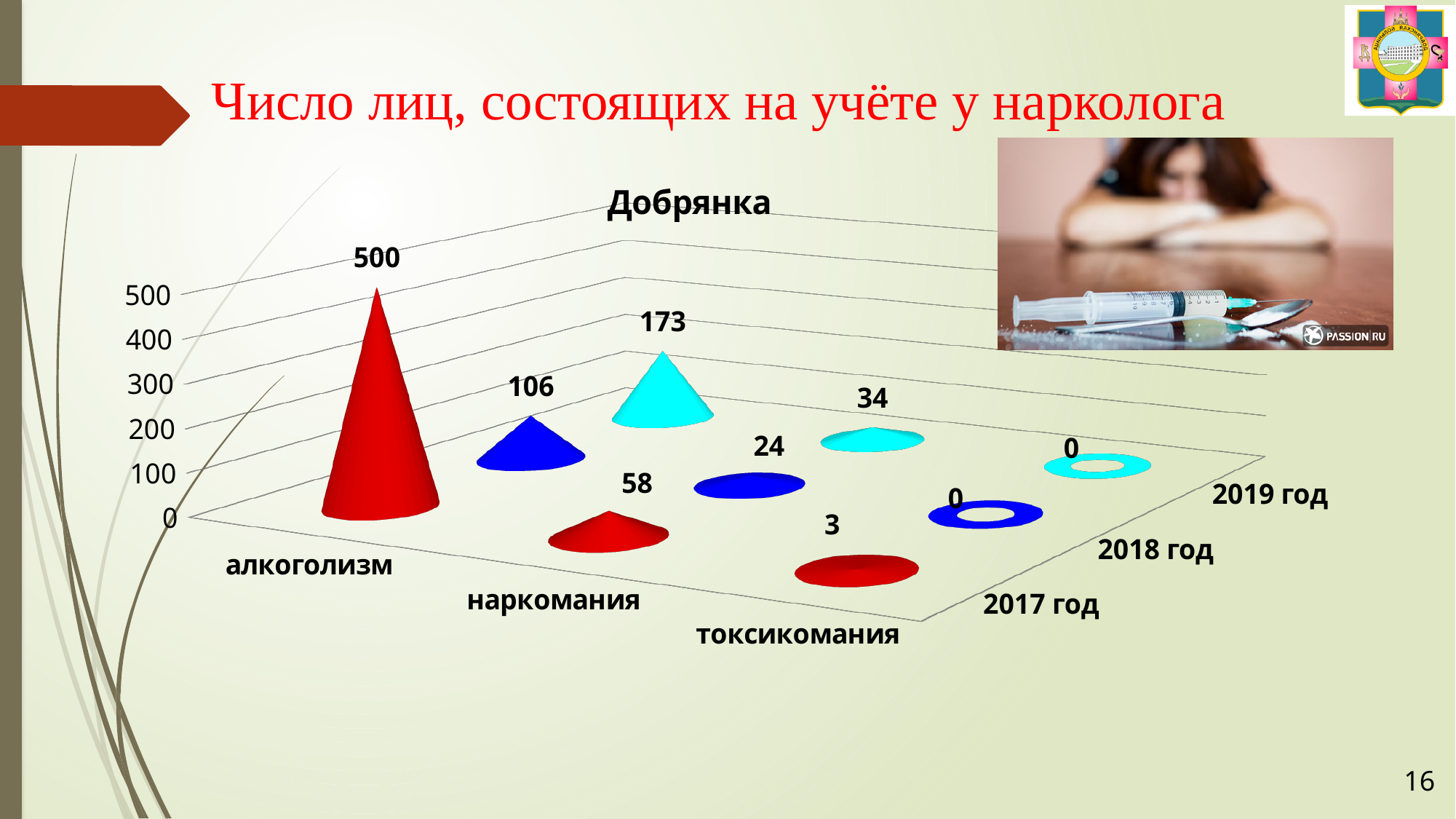
What is the value for алкоголизм in 2017 год? 500 What is the value for токсикомания in 2017 год? 3 Which category has the lowest value in 2018 год? токсикомания What is the title of the chart? Добрянка How many years are plotted on the chart? 3 Does the value for алкоголизм rise or fall from 2018 год to 2019 год? rise How many categories are shown on the chart? 3 What is the value for алкоголизм in 2018 год? 106 What is the difference between the алкоголизм values for 2017 год and 2018 год? 394 Which is larger: наркомания in 2017 год or наркомания in 2018 год? наркомания in 2017 год Which category has the highest value in 2019 год? алкоголизм What is the value for наркомания in 2019 год? 34